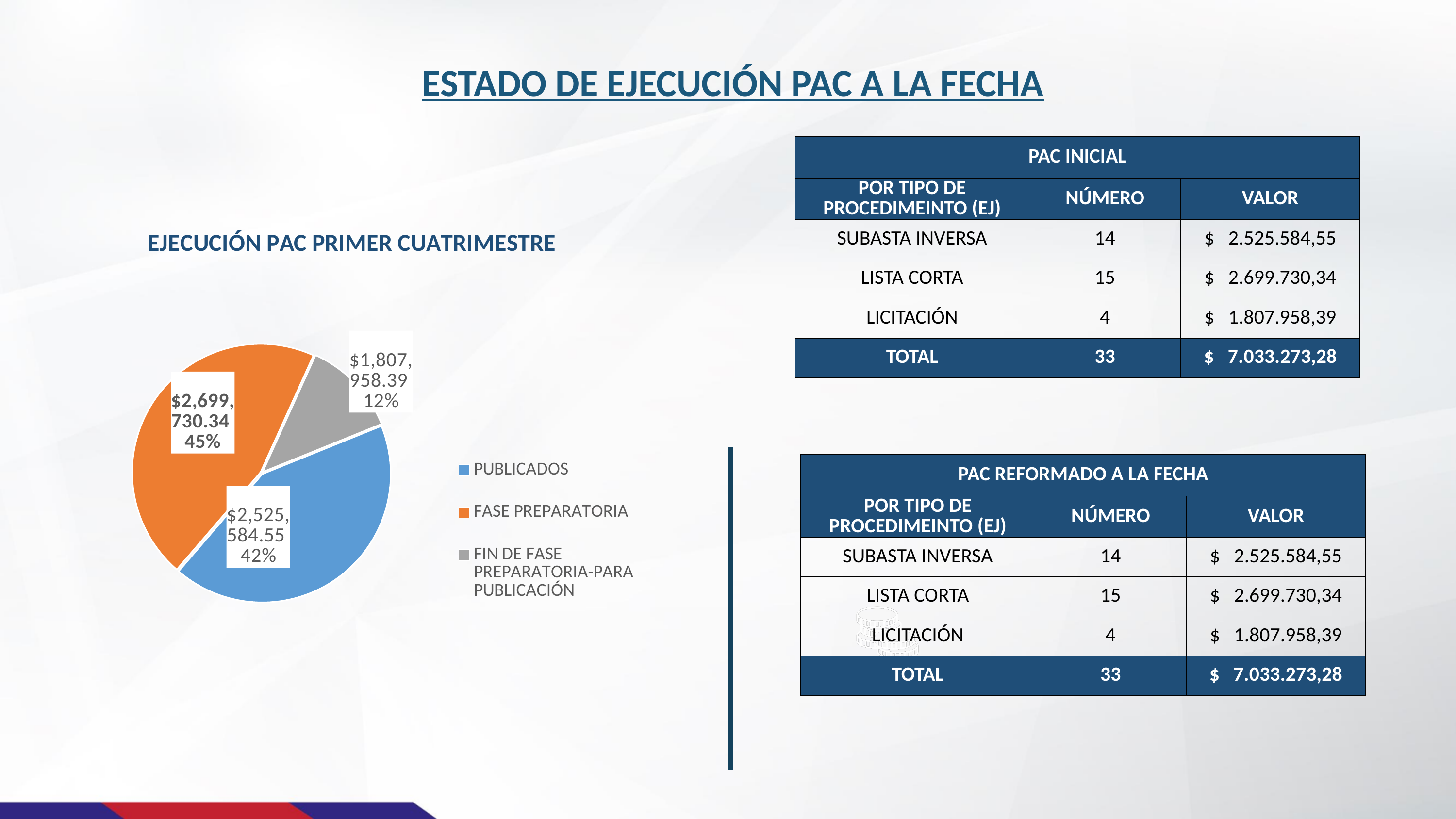
Which colour represents PUBLICADOS in the pie chart? Blue What kind of chart is shown on the slide? Pie chart Which category has the largest slice in the pie chart? FASE PREPARATORIA Which category has the smallest slice in the pie chart? FIN DE FASE PREPARATORIA-PARA PUBLICACIÓN What share of the pie does FIN DE FASE PREPARATORIA-PARA PUBLICACIÓN represent? 12% What value is shown for FIN DE FASE PREPARATORIA-PARA PUBLICACIÓN in the pie chart? $1,807,958.39 What value is shown for PUBLICADOS in the pie chart? $2,525,584.55 What share of the pie does PUBLICADOS represent? 42% What is the title of the pie chart? EJECUCIÓN PAC PRIMER CUATRIMESTRE What share of the pie does FASE PREPARATORIA represent? 45% How many slices does the pie chart have? 3 What value is shown for FASE PREPARATORIA in the pie chart? $2,699,730.34